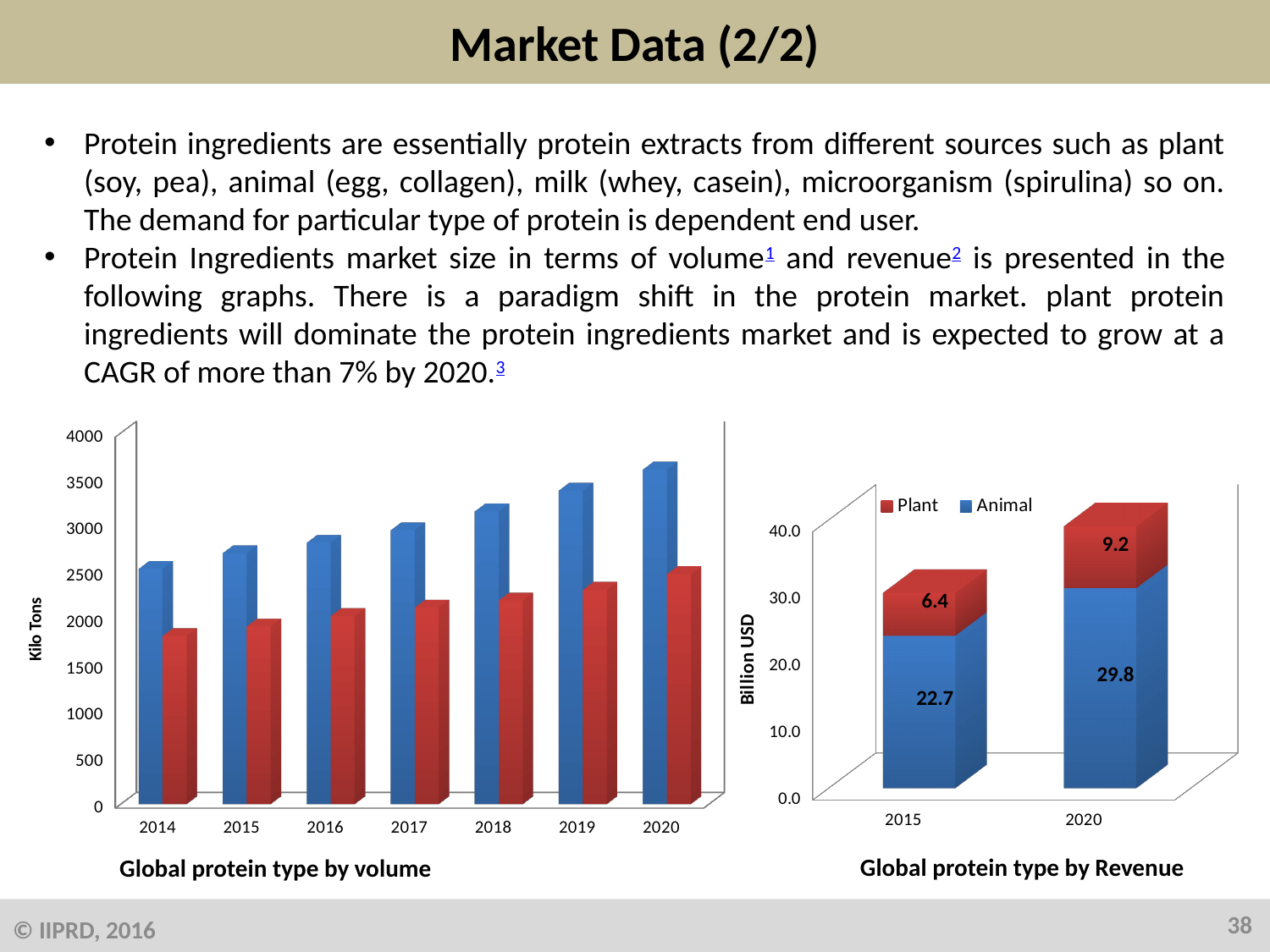
How many years are shown on the x axis of the 'Global protein type by volume' chart? 7 In the 'Global protein type by Revenue' chart, what is the total of the stacked bar for 2020? 39.0 How many series does the legend of the 'Global protein type by Revenue' chart list? 2 In the 'Global protein type by volume' chart, do the blue bars rise or fall from 2014 to 2020? rise In the 'Global protein type by Revenue' chart, by how much does the Animal value increase from 2015 to 2020? 7.1 In the 'Global protein type by Revenue' chart, what is the Animal value for 2015? 22.7 In the 'Global protein type by Revenue' chart, what is the total of the stacked bar for 2015? 29.1 In the 'Global protein type by volume' chart, is the value of the red bar for 2014 greater or less than 2000? less What is the y-axis label of the 'Global protein type by Revenue' chart? Billion USD In the 'Global protein type by Revenue' chart, what is the Plant value for 2020? 9.2 In the 'Global protein type by Revenue' chart, which is larger in 2020, Plant or Animal? Animal In the 'Global protein type by volume' chart, is the value of the blue bar for 2020 greater or less than 3000? greater